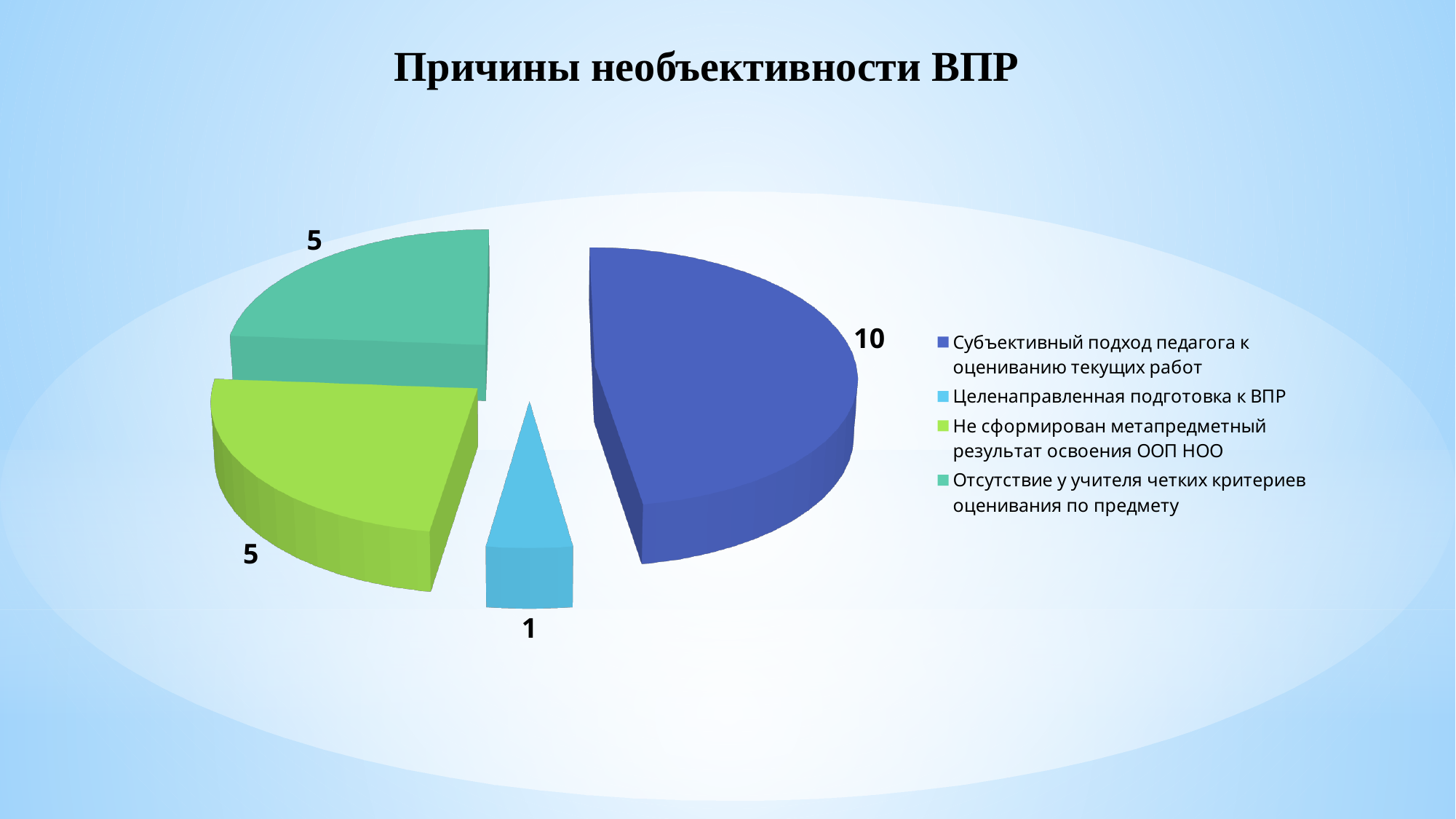
What is the title of the chart? Причины необъективности ВПР What is the value for "Целенаправленная подготовка к ВПР"? 1 What is the value for "Не сформирован метапредметный результат освоения ООП НОО"? 5 What is the value for "Отсутствие у учителя четких критериев оценивания по предмету"? 5 Which category has the largest slice of the pie? Субъективный подход педагога к оцениванию текущих работ How many slices does the pie chart have? 4 What is the value for "Субъективный подход педагога к оцениванию текущих работ"? 10 Which is larger: the value for "Субъективный подход педагога к оцениванию текущих работ" or the value for "Не сформирован метапредметный результат освоения ООП НОО"? Субъективный подход педагога к оцениванию текущих работ What kind of chart is shown on the slide? Pie chart What is the sum of all the slice values in the pie chart? 21 Which category has the smallest slice of the pie? Целенаправленная подготовка к ВПР What is the difference between the value for "Субъективный подход педагога к оцениванию текущих работ" and the value for "Целенаправленная подготовка к ВПР"? 9